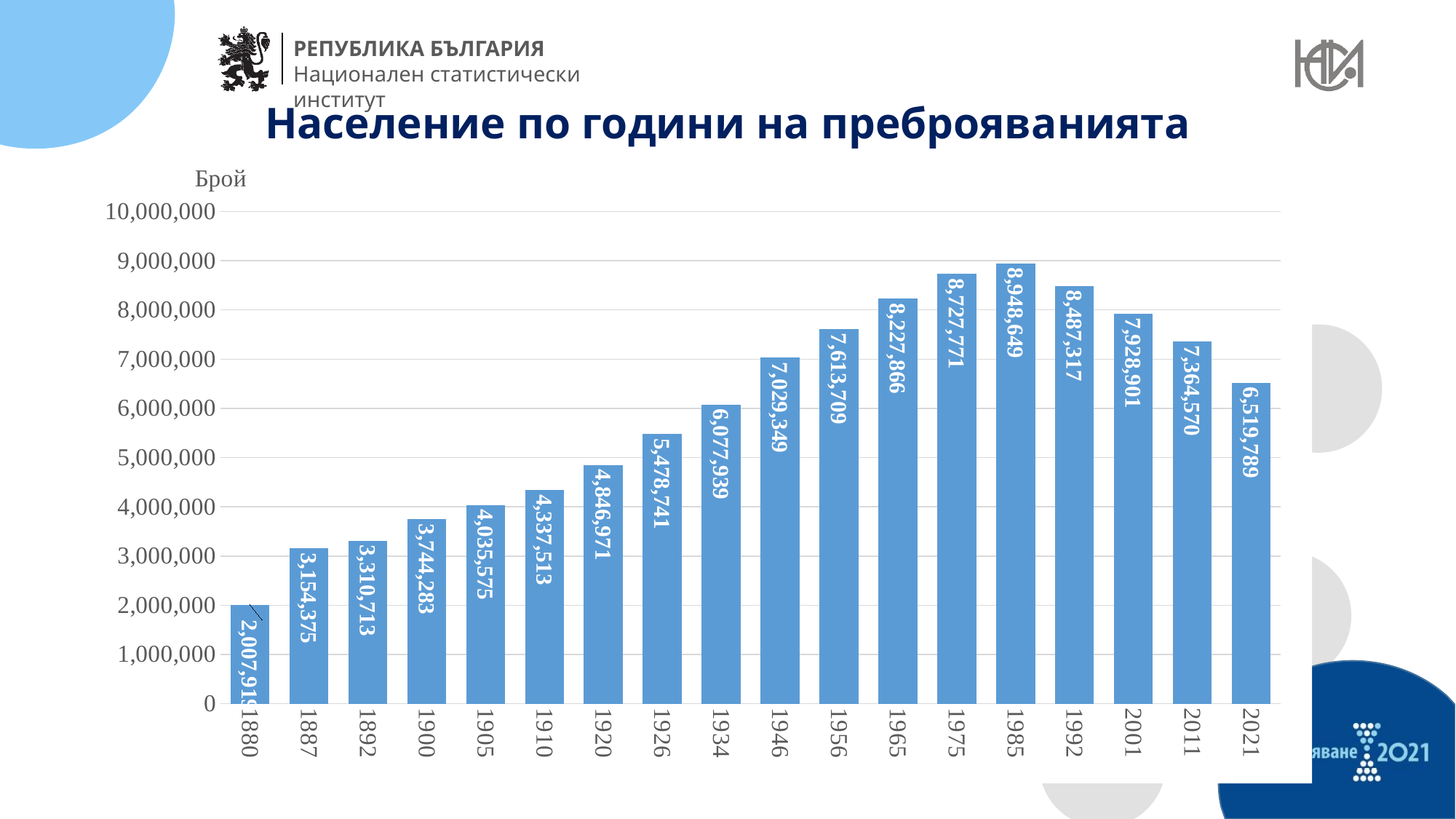
What is the population value shown for 1946? 7,029,349 Is the population value for 1934 greater or less than 6,000,000? greater What type of chart is shown on the slide? bar chart Which is larger, the population in 1992 or in 2001? 1992 What is the population value shown for 1900? 3,744,283 What is the population value shown for 2021? 6,519,789 What is the difference between the population in 2011 and in 2021? 844,781 Which census year has the highest population? 1985 How many census years are shown in the chart? 18 Which census year has the lowest population? 1880 What is the population value shown for 1985? 8,948,649 What is the difference between the population in 1985 and in 2021? 2,428,860